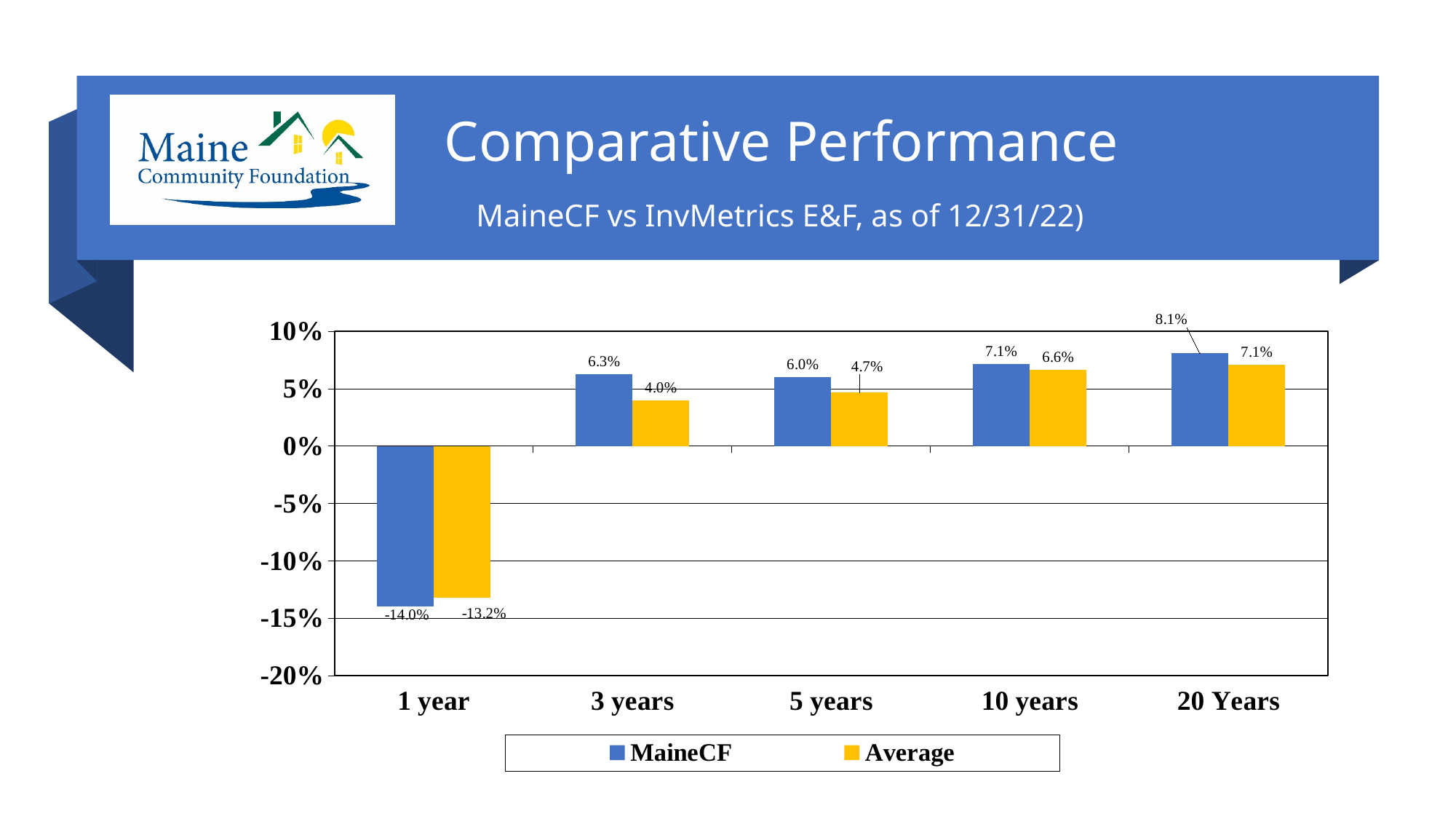
Which is larger for 5 years, MaineCF or Average? MaineCF Which period has the highest MaineCF value? 20 Years What is the Average value for 1 year? -13.2% What is the Average value for 10 years? 6.6% What kind of chart is shown on the slide? Bar chart What is the MaineCF value for 3 years? 6.3% How many series does the legend list? 2 Which colour represents the Average series? Yellow Which period has the lowest Average value? 1 year How many time periods are shown on the x axis? 5 What is the difference between the MaineCF and Average values for 3 years? 2.3% What is the MaineCF value for 20 Years? 8.1%